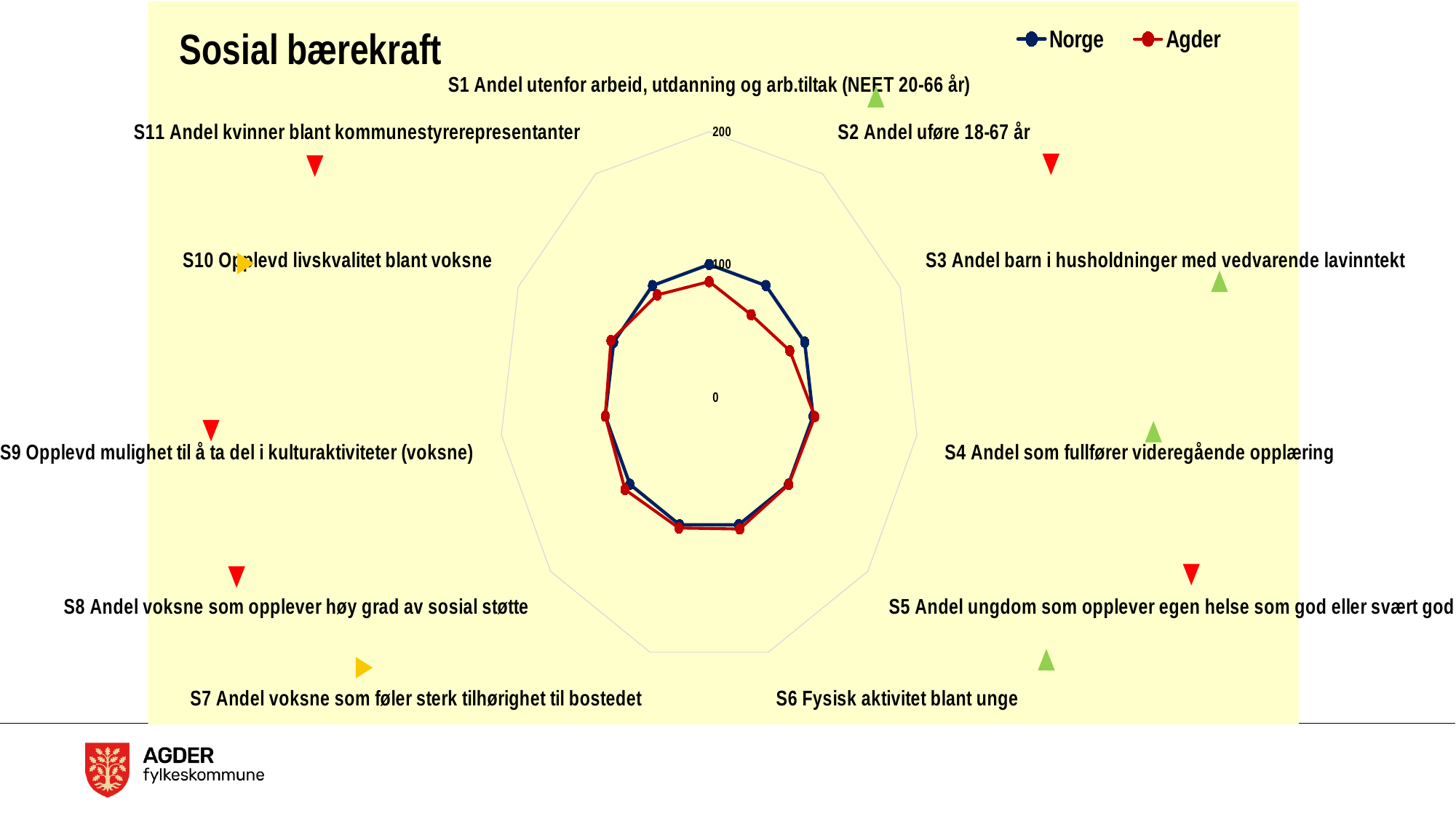
Which series has the larger value for S2 Andel uføre 18-67 år, Norge or Agder? Norge Is the Agder value for S3 Andel barn i husholdninger med vedvarende lavinntekt greater or less than 100? less Which two series are shown in the legend? Norge and Agder Is the Agder value for S2 Andel uføre 18-67 år greater or less than 100? less Is the Norge value for S4 Andel som fullfører videregående opplæring greater or less than 200? less What is the title of the chart? Sosial bærekraft Which series has the larger value for S3 Andel barn i husholdninger med vedvarende lavinntekt, Norge or Agder? Norge Which series has the larger value for S1 Andel utenfor arbeid, utdanning og arb.tiltak (NEET 20-66 år), Norge or Agder? Norge What kind of chart is shown on the slide? radar chart How many series does the legend list? 2 How many categories (indicators) are plotted on the radar chart? 11